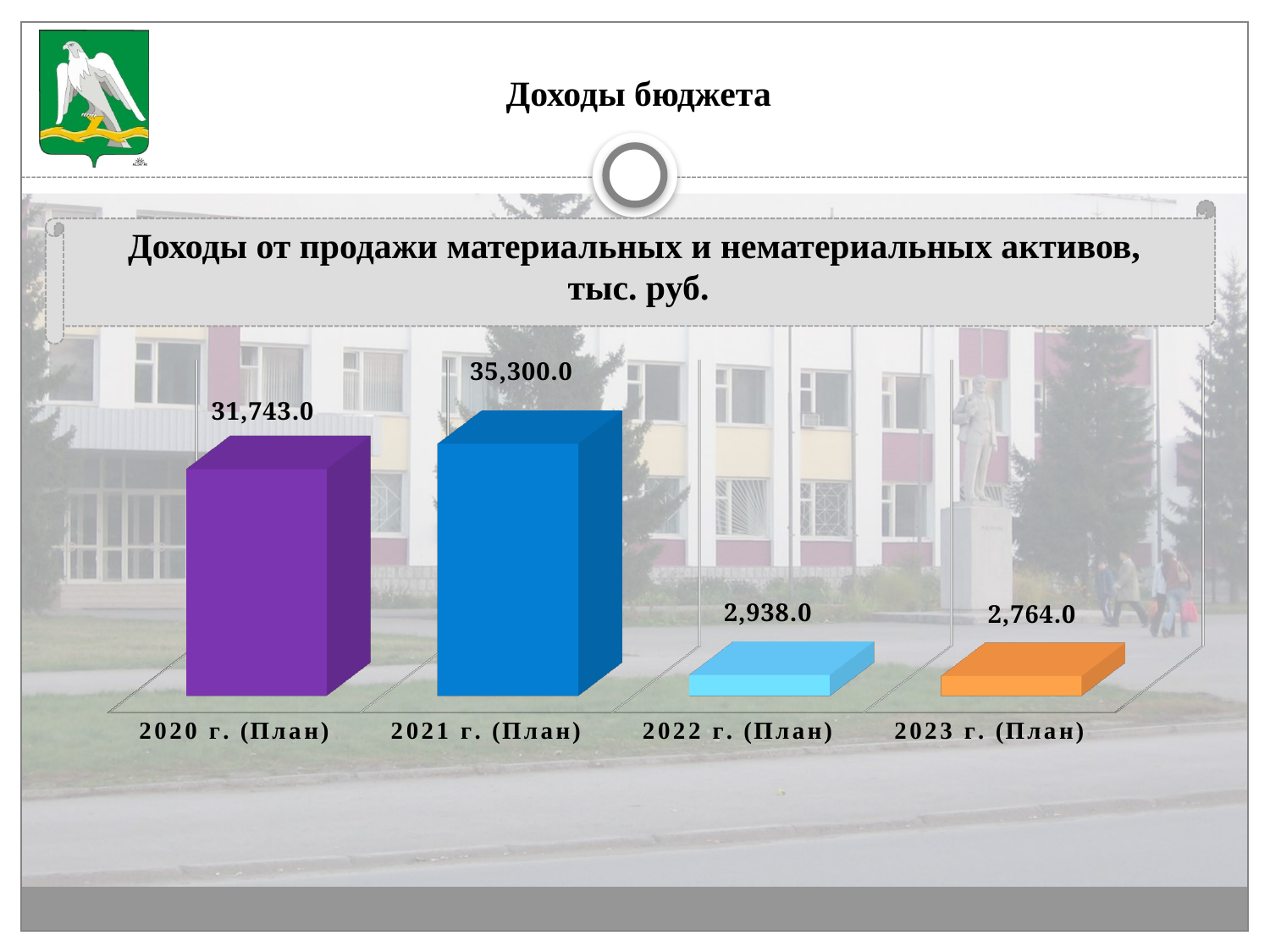
Which is larger, the value for 2020 г. (План) or 2022 г. (План)? 2020 г. (План) What is the title of the chart? Доходы от продажи материальных и нематериальных активов, тыс. руб. What kind of chart is shown on the slide? Bar chart What is the difference between the values for 2021 г. (План) and 2020 г. (План)? 3,557.0 What is the value for 2022 г. (План)? 2,938.0 What is the value for 2021 г. (План)? 35,300.0 What is the difference between the values for 2022 г. (План) and 2023 г. (План)? 174.0 What is the value for 2020 г. (План)? 31,743.0 How many categories are shown on the chart? 4 Which year has the highest value? 2021 г. (План) Which year has the lowest value? 2023 г. (План) What is the value for 2023 г. (План)? 2,764.0